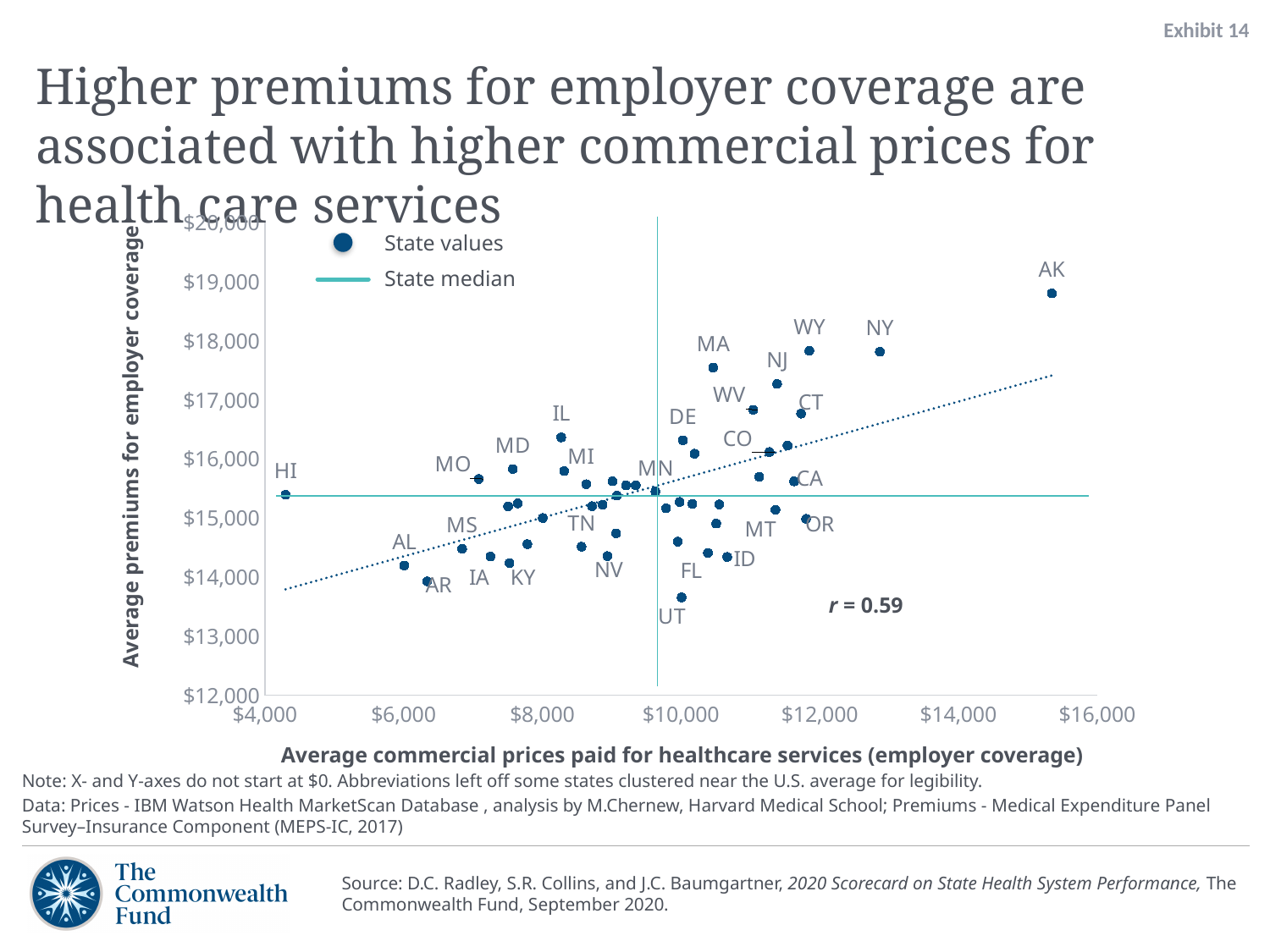
What kind of chart is shown on the slide? Scatter plot Is the average premium for employer coverage for UT greater or less than $14,000? less Is the average commercial price paid for healthcare services for NY greater or less than $12,000? greater As average commercial prices increase along the x axis, do average premiums for employer coverage generally rise or fall? Rise Which state has the lowest average commercial prices paid for healthcare services? HI Is the average premium for employer coverage for AK greater or less than $18,000? greater Which state has the lowest average premium for employer coverage? UT How many entries does the chart legend list? 2 What correlation coefficient (r) is printed on the chart? r = 0.59 Which state has the higher average premium for employer coverage, AK or NY? AK Which state has the highest average premium for employer coverage? AK